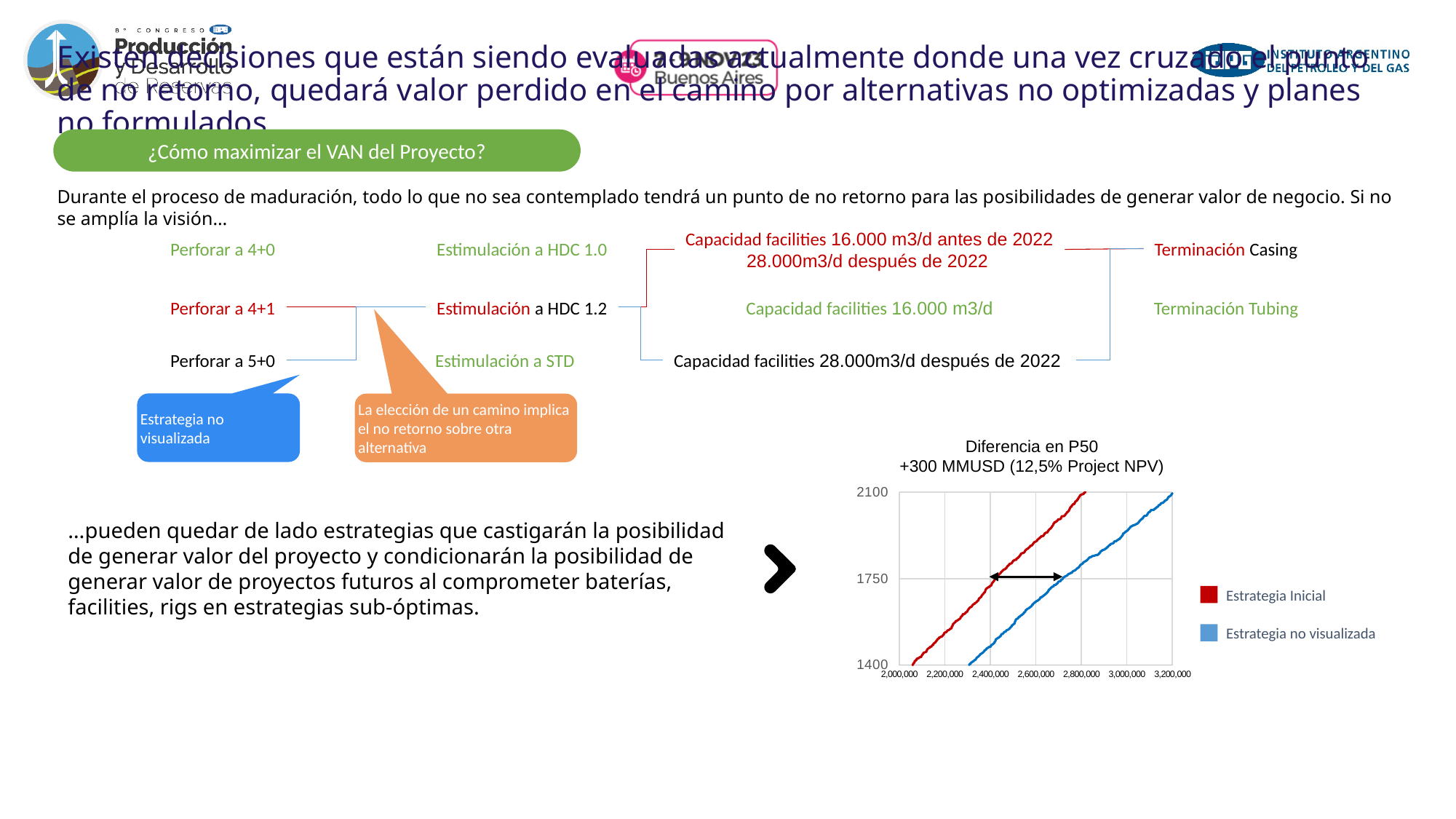
Which series reaches the 2100 level at a smaller x-axis value: Estrategia Inicial or Estrategia no visualizada? Estrategia Inicial What are the two series named in the chart legend? Estrategia Inicial; Estrategia no visualizada Which colour represents the 'Estrategia Inicial' series in the chart? red How many series does the chart legend list? 2 At the 1750 level on the vertical axis, is the x-axis value of the Estrategia Inicial line greater or less than 2,600,000? less What is the highest value shown on the chart's vertical axis? 2100 Do the lines in the chart rise or fall as the x-axis values increase? rise What kind of chart is shown on the slide? line chart At the 1750 level on the vertical axis, is the x-axis value of the Estrategia no visualizada line greater or less than 2,600,000? greater At the 1750 level on the vertical axis, which series has the larger x-axis value: Estrategia Inicial or Estrategia no visualizada? Estrategia no visualizada